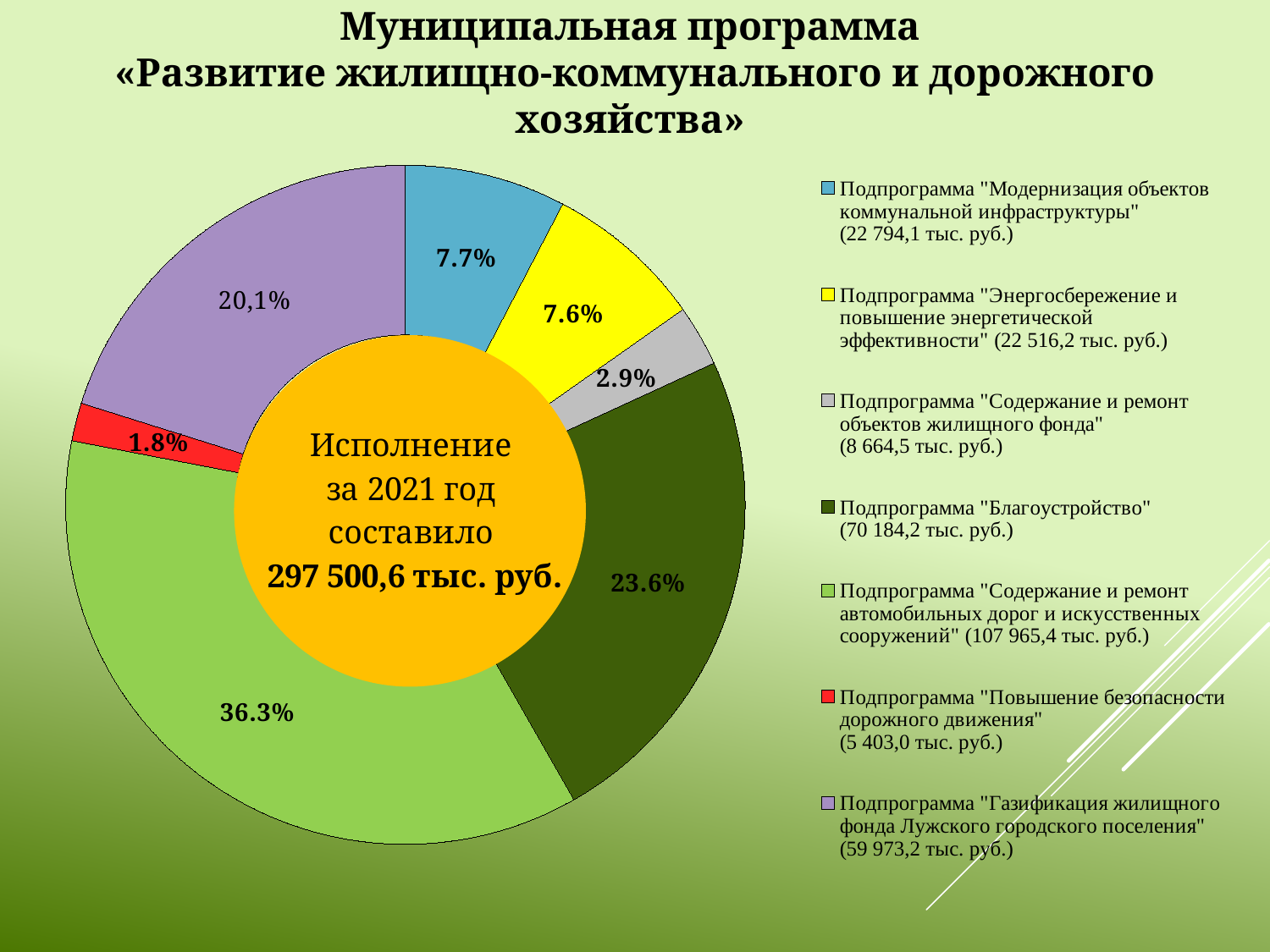
What total execution amount for 2021 is shown in the centre of the chart? 297 500,6 тыс. руб. Which subprogram has the largest share of the pie? Подпрограмма "Содержание и ремонт автомобильных дорог и искусственных сооружений" What share of the pie does the subprogram "Повышение безопасности дорожного движения" have? 1.8% What kind of chart is shown on the slide? Doughnut chart What share of the pie does the subprogram "Содержание и ремонт автомобильных дорог и искусственных сооружений" have? 36.3% What share of the pie does the subprogram "Благоустройство" have? 23.6% What is the difference in percentage points between the shares of "Содержание и ремонт автомобильных дорог и искусственных сооружений" and "Благоустройство"? 12.7 Which subprogram has the smallest share of the pie? Подпрограмма "Повышение безопасности дорожного движения" How many slices does the pie chart have? 7 Which has a larger share: "Благоустройство" or "Газификация жилищного фонда Лужского городского поселения"? Благоустройство According to the legend, what amount in thousand rubles corresponds to the subprogram "Благоустройство"? 70 184,2 тыс. руб.